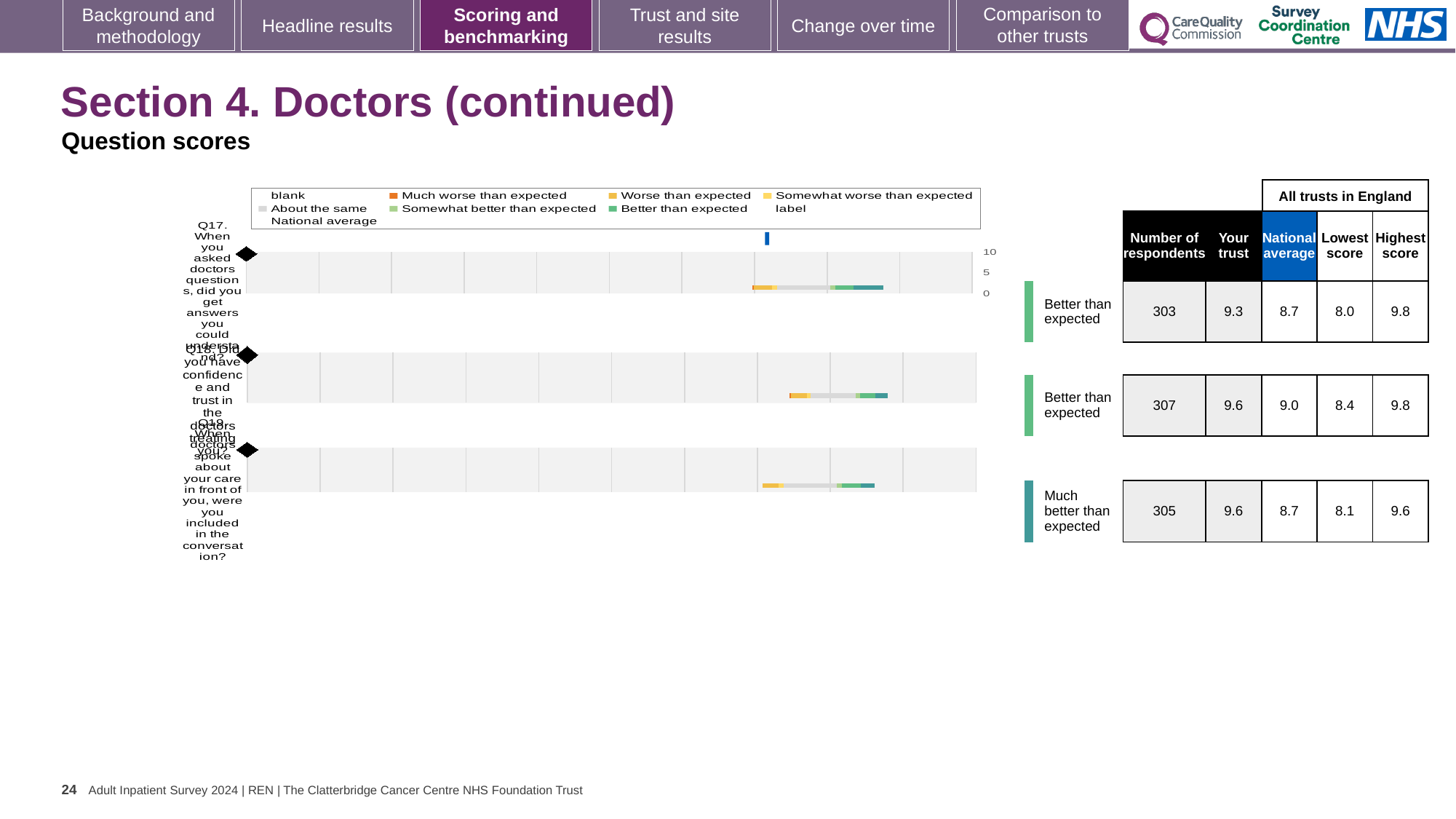
What is the highest score among all trusts in England for Q19? 9.6 How many respondents answered Q19 (When doctors spoke about your care in front of you, were you included in the conversation?)? 305 What benchmark category is shown for Q19 next to the chart? Much better than expected Which of the three questions has the lowest 'Your trust' score? Q17 Which is larger for Q17: the 'Your trust' score or the national average? Your trust How many entries does the legend of the question scores chart list? 9 What is the national average score for Q18 (Did you have confidence and trust in the doctors treating you?)? 9.0 What kind of chart is used to show the question scores on this slide? bar chart How many questions (categories) are plotted in the question scores chart? 3 What is the 'Your trust' score for Q17 (When you asked doctors questions, did you get answers you could understand?)? 9.3 Is the 'Your trust' score for Q17 greater or less than 5 on the chart's axis? greater What is the difference between the 'Your trust' score and the national average for Q18? 0.6